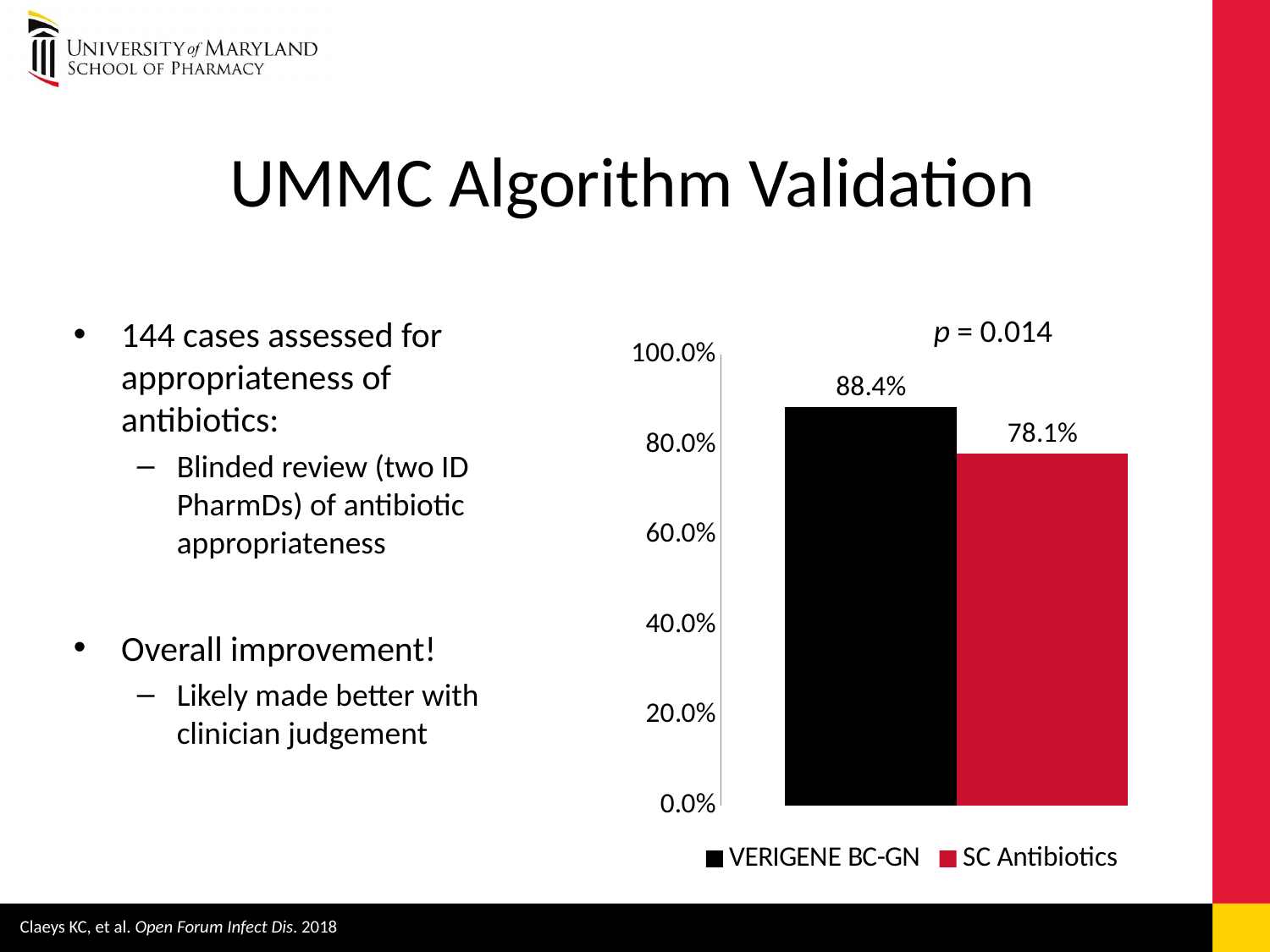
Which series has the lowest value? SC Antibiotics What kind of chart is shown on the slide? bar chart Which is larger, the value for VERIGENE BC-GN or the value for SC Antibiotics? VERIGENE BC-GN What p-value is shown above the chart? p = 0.014 Is the value for SC Antibiotics greater or less than 80.0%? less What is the value for VERIGENE BC-GN? 88.4% What colour is the bar for SC Antibiotics? red Is the value for VERIGENE BC-GN greater or less than 80.0%? greater Which series has the highest value? VERIGENE BC-GN How many series does the legend list? 2 What is the value for SC Antibiotics? 78.1% What is the difference between the VERIGENE BC-GN value and the SC Antibiotics value? 10.3%